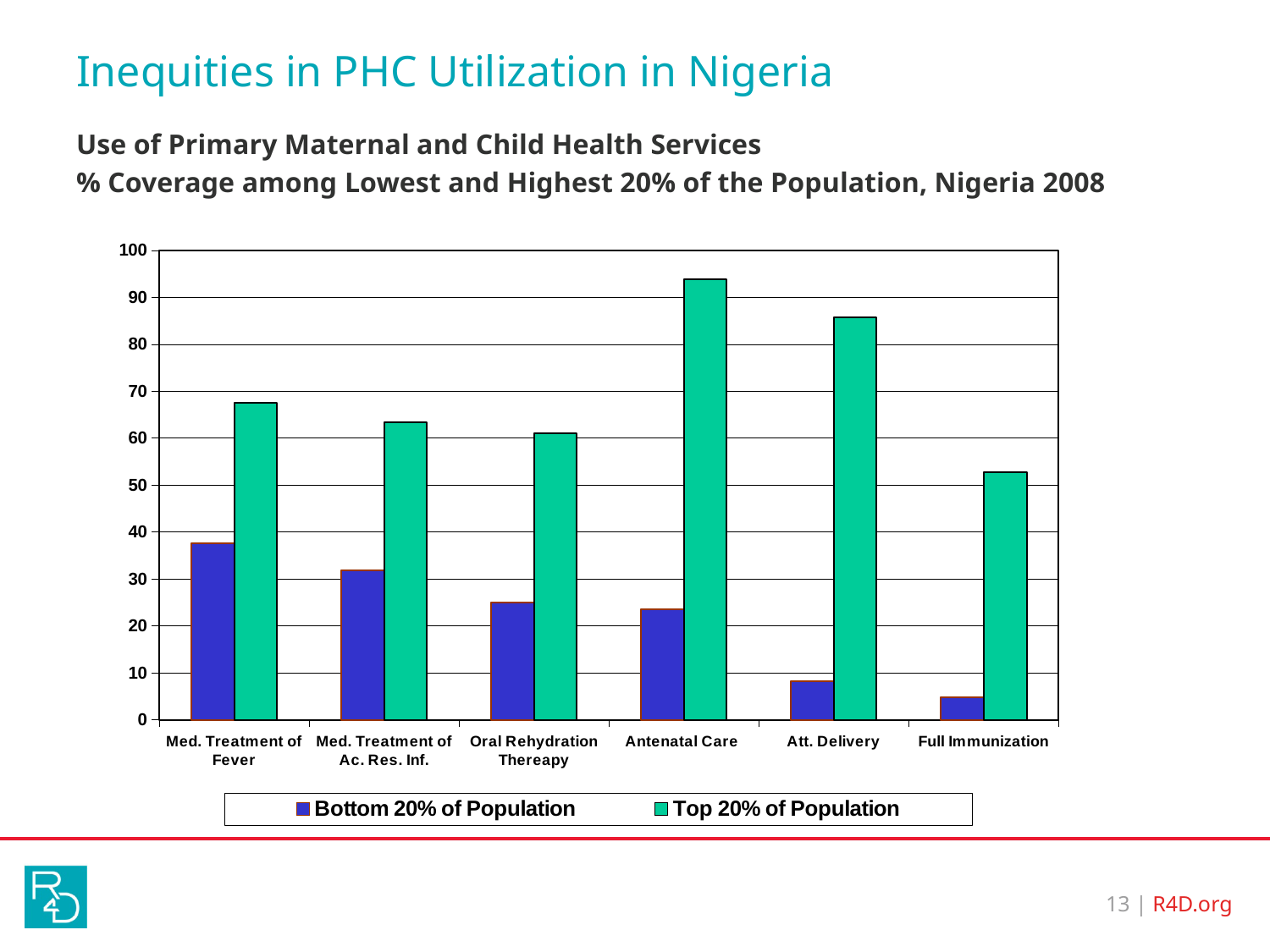
Which is larger for Att. Delivery: the Bottom 20% of Population value or the Top 20% of Population value? Top 20% of Population What kind of chart is shown on the slide? bar chart Which colour represents the Top 20% of Population series? green Is the Bottom 20% of Population value for Med. Treatment of Fever greater or less than 40? less For which service is the Bottom 20% of Population value lowest? Full Immunization How many series does the legend list? 2 How many service categories are shown on the x axis? 6 For which service is the Top 20% of Population value highest? Antenatal Care For which service is the Bottom 20% of Population value highest? Med. Treatment of Fever Is the Bottom 20% of Population value for Att. Delivery greater or less than 10? less Is the Top 20% of Population value for Antenatal Care greater or less than 90? greater For which service is the Top 20% of Population value lowest? Full Immunization